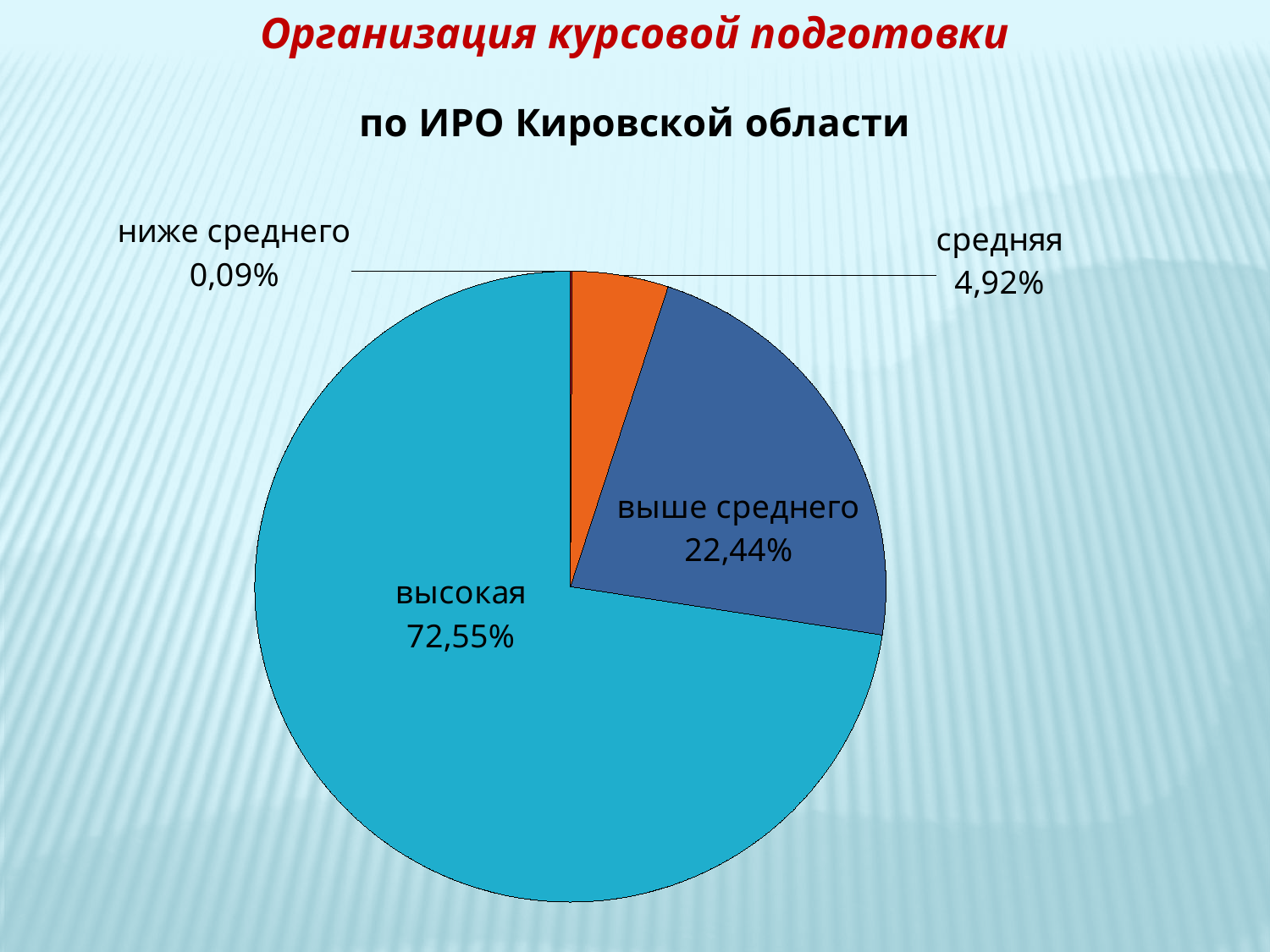
Which is larger, the share for "средняя" or the share for "выше среднего"? выше среднего What is the value shown for "выше среднего"? 22,44% What is the difference between the shares of "выше среднего" and "средняя"? 17,52% What is the value shown for "средняя"? 4,92% What colour is the "выше среднего" slice? dark blue Which category has the smallest share of the pie? ниже среднего What is the difference between the shares of "высокая" and "выше среднего"? 50,11% Which category has the largest share of the pie? высокая What share of the pie does the "высокая" slice represent? 72,55% How many slices does the pie chart have? 4 What kind of chart is shown on the slide? pie chart What is the value shown for "ниже среднего"? 0,09%